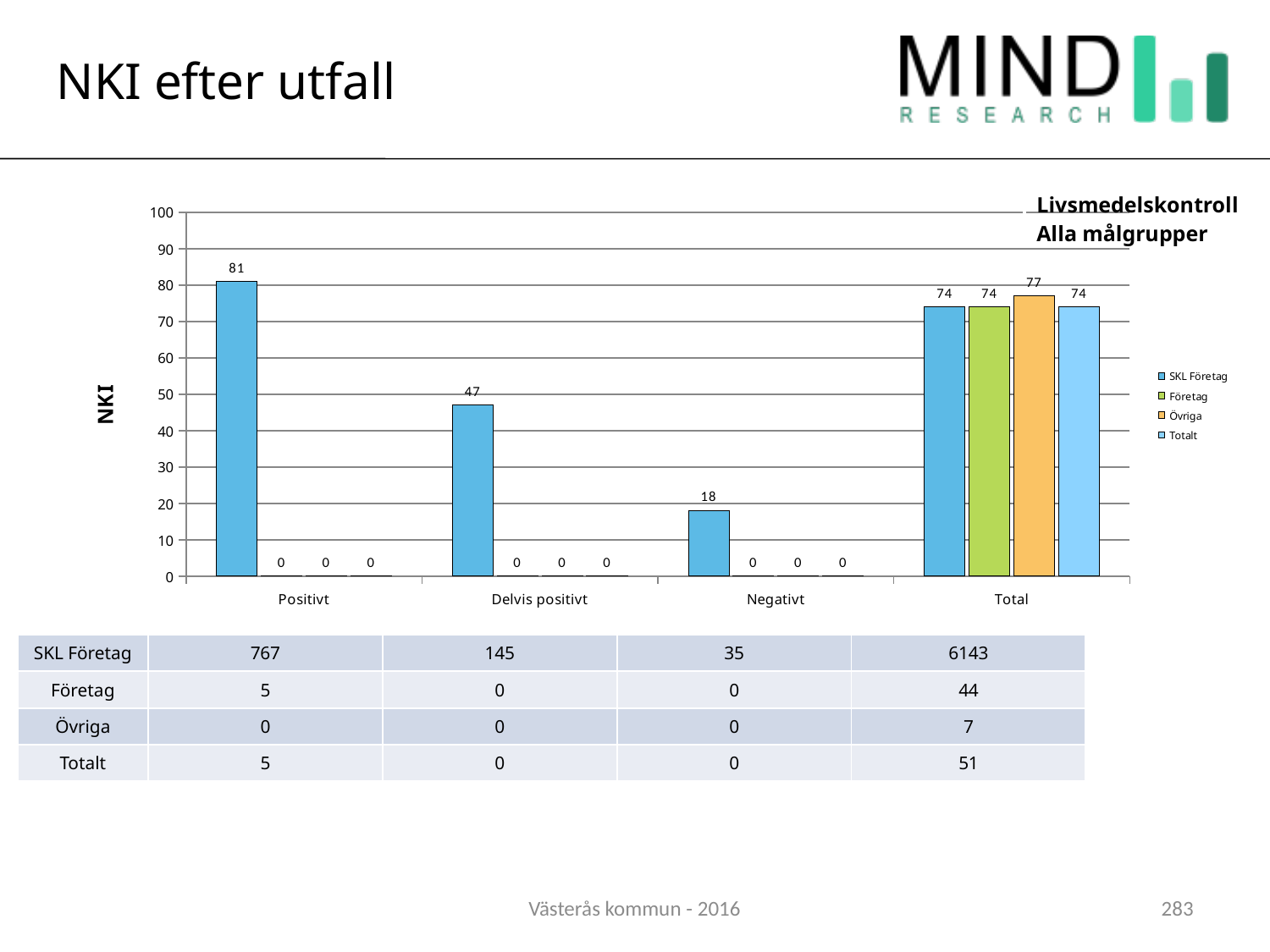
What is the NKI value for Företag in the Total category? 74 Which category has the lowest NKI value for SKL Företag? Negativt What is the NKI value for Övriga in the Total category? 77 How many categories are shown on the x axis? 4 What kind of chart is shown on the slide? Bar chart What is the NKI value for SKL Företag in the Negativt category? 18 How many series does the legend list? 4 Which category has the highest NKI value for SKL Företag? Positivt What is the difference between the SKL Företag values for Positivt and Delvis positivt? 34 What is the NKI value for SKL Företag in the Positivt category? 81 Which is larger in the Total category: the value for Övriga or the value for Totalt? Övriga What is the NKI value for SKL Företag in the Delvis positivt category? 47